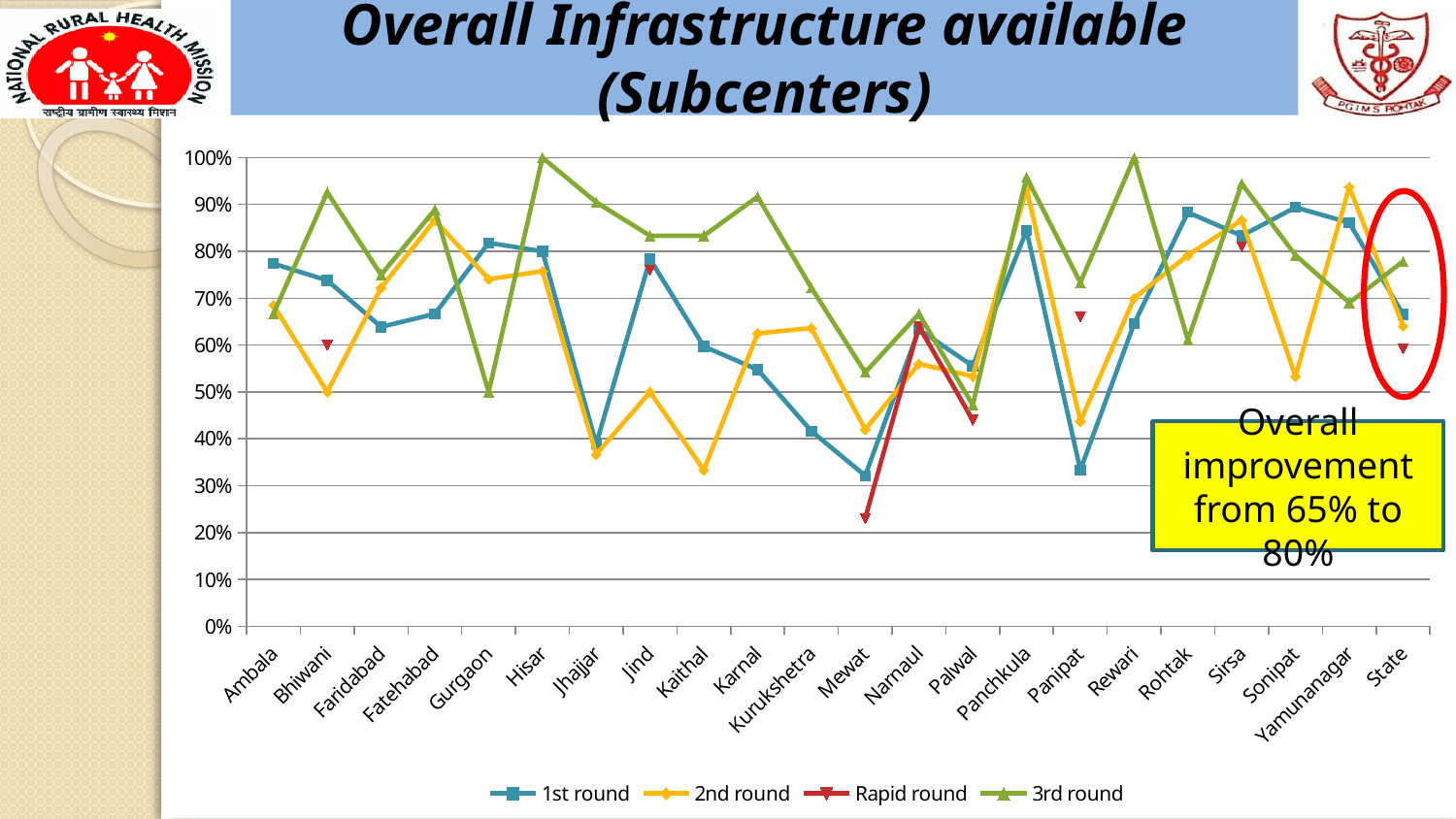
Which category has the lowest Rapid round value? Mewat What kind of chart is shown on the slide? line chart What is the title of the chart? Overall Infrastructure available (Subcenters) What is the 3rd round value for Hisar? 100% Which is larger for the 1st round: Hisar or Jhajjar? Hisar Is the 1st round value for Rohtak greater or less than 80%? greater Which category has the lowest 2nd round value? Kaithal Is the Rapid round value for Mewat greater or less than 30%? less Do the 1st round values rise or fall from Kaithal to Mewat? fall How many series does the legend list? 4 How many categories are shown along the x axis? 22 Is the 1st round value for Mewat greater or less than 40%? less